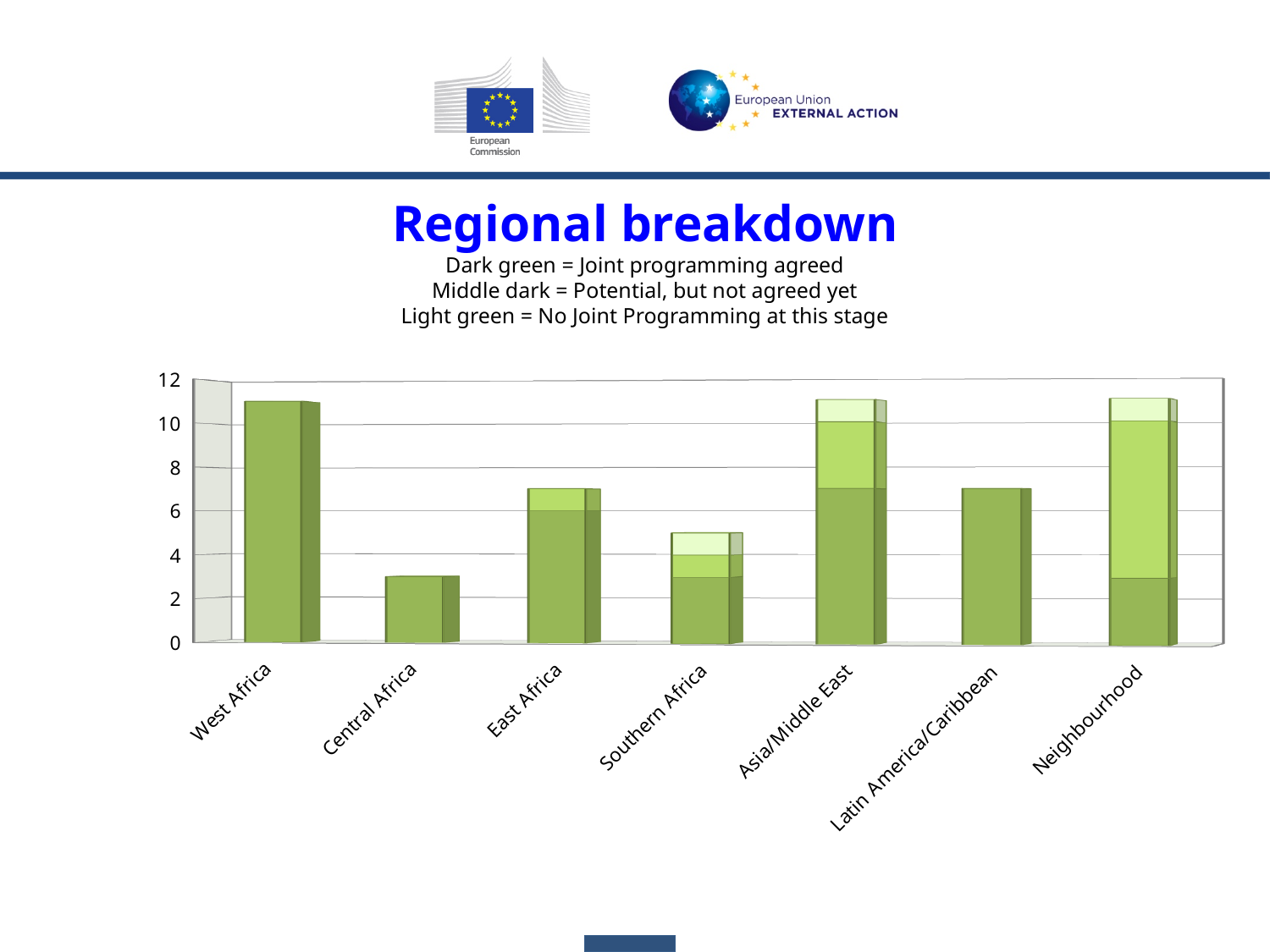
Which has the larger total bar, Southern Africa or Asia/Middle East? Asia/Middle East Which has the larger total bar, West Africa or Central Africa? West Africa What is the title of the chart on the slide? Regional breakdown Is the total value for Latin America/Caribbean greater or less than 6? greater Which region has the lowest total bar in the chart? Central Africa Is the total value for Central Africa greater or less than 4? less What kind of chart is shown on the slide? bar chart Is the total value for Neighbourhood greater or less than 10? greater How many regions are shown on the x axis of the chart? 7 According to the slide, what does the dark green colour in the chart represent? Joint programming agreed